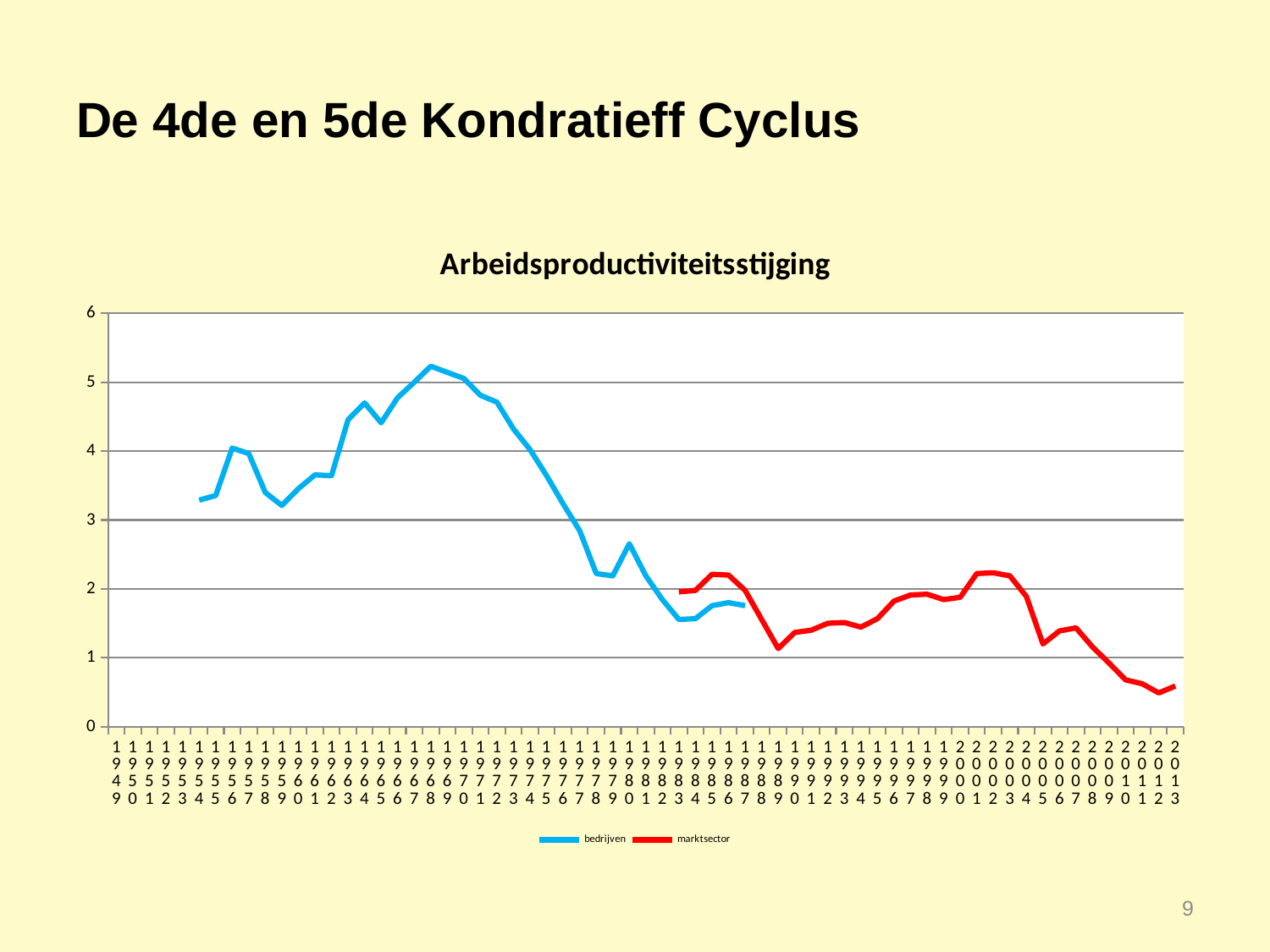
How many series does the legend list? 2 What kind of chart is shown on the slide? line chart Is the value for marktsector in 1995 greater or less than 2? less Is the value for bedrijven in 1968 greater or less than 5? greater What is the title of the chart? Arbeidsproductiviteitsstijging Which colour is used for the marktsector series? red Is the value for bedrijven in 1975 greater or less than 3? greater Which is larger: the bedrijven value in 1968 or the marktsector value in 2001? bedrijven in 1968 Does the bedrijven series rise or fall between 1968 and 1982? fall Does the marktsector series rise or fall between 2003 and 2011? fall